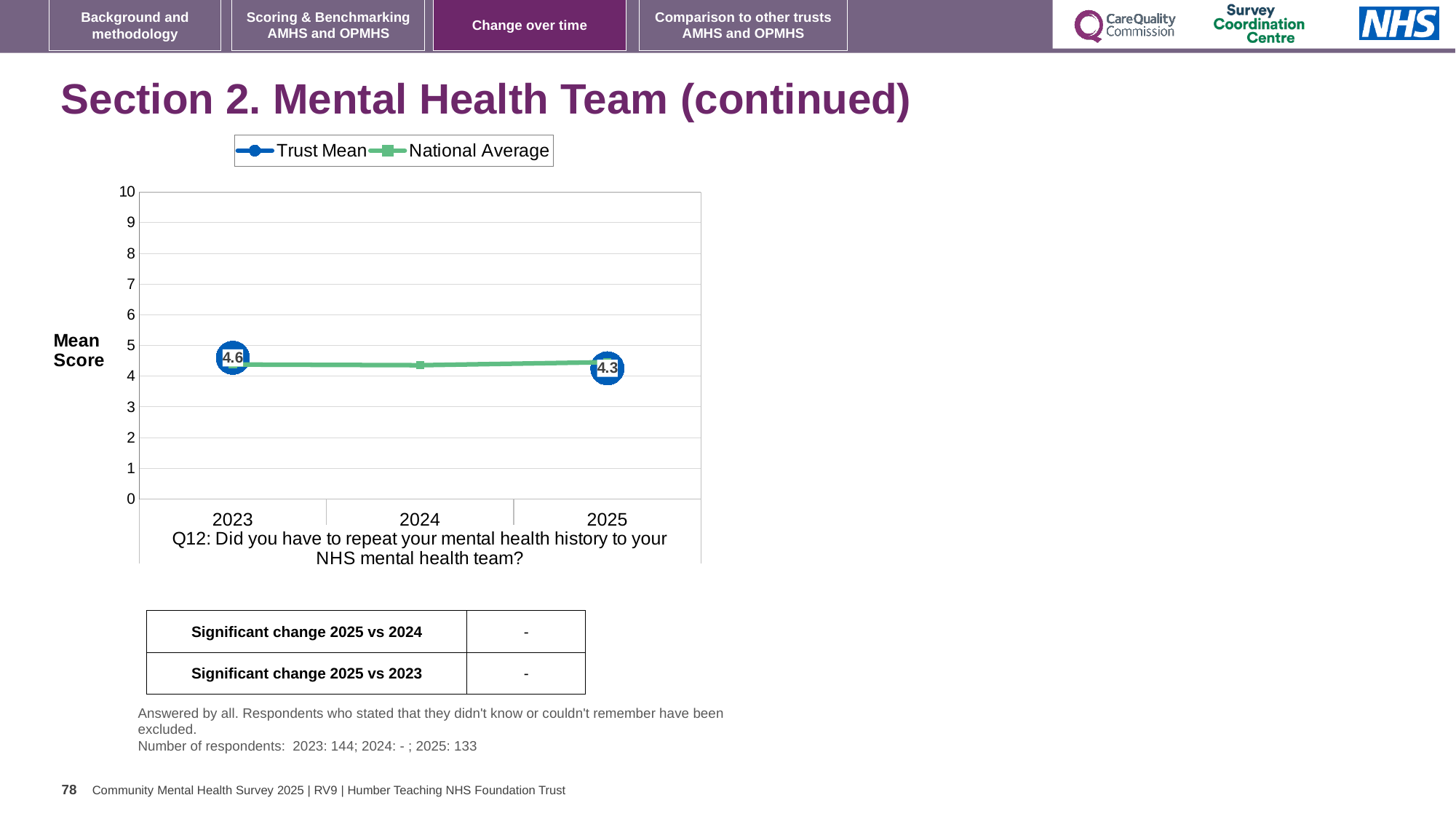
What is the label on the y axis of the chart? Mean Score By how much did the Trust Mean change between 2023 and 2025? 0.3 Is the National Average value for 2024 greater or less than 4? greater What is the Trust Mean value for 2023? 4.6 Which year has the higher Trust Mean, 2023 or 2025? 2023 How many years are shown on the x axis? 3 Does the Trust Mean rise or fall from 2023 to 2025? fall What kind of chart is shown on the slide? line chart In which year is the Trust Mean highest? 2023 How many series does the legend list? 2 Is the National Average value for 2024 greater or less than 5? less What is the Trust Mean value for 2025? 4.3